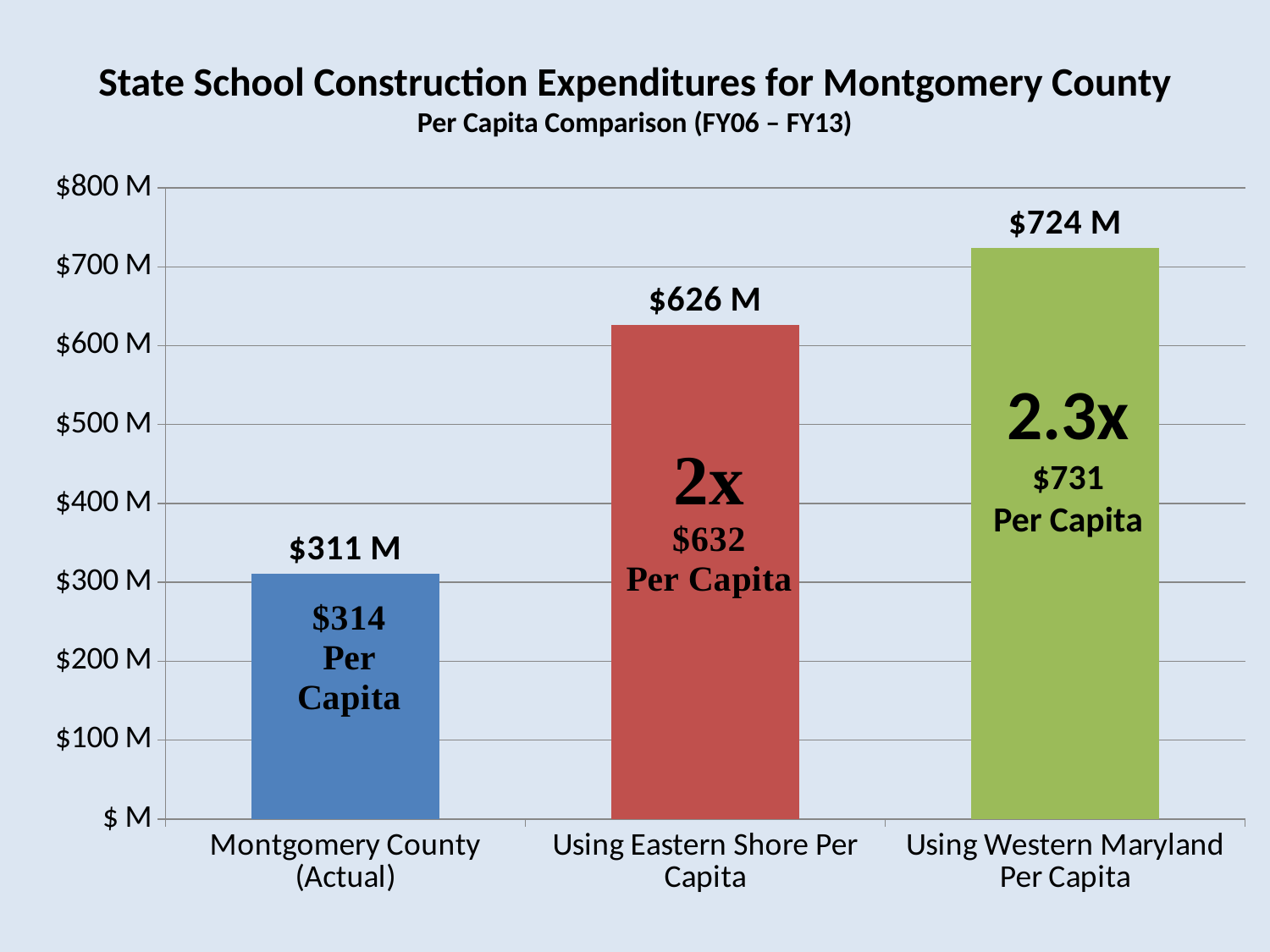
What is the value for Using Western Maryland Per Capita? $724 M What is the difference between the Using Western Maryland Per Capita value and the Montgomery County (Actual) value? $413 M Is the value for Montgomery County (Actual) greater or less than $400 M? less What kind of chart is shown on the slide? bar chart Which is larger, the value for Using Eastern Shore Per Capita or the value for Using Western Maryland Per Capita? Using Western Maryland Per Capita Which category has the highest value? Using Western Maryland Per Capita How many categories are shown on the chart? 3 Which category has the lowest value? Montgomery County (Actual) What is the difference between the Using Eastern Shore Per Capita value and the Montgomery County (Actual) value? $315 M What is the value for Montgomery County (Actual)? $311 M What per capita amount is printed inside the Using Eastern Shore Per Capita bar? $632 Per Capita What is the value for Using Eastern Shore Per Capita? $626 M